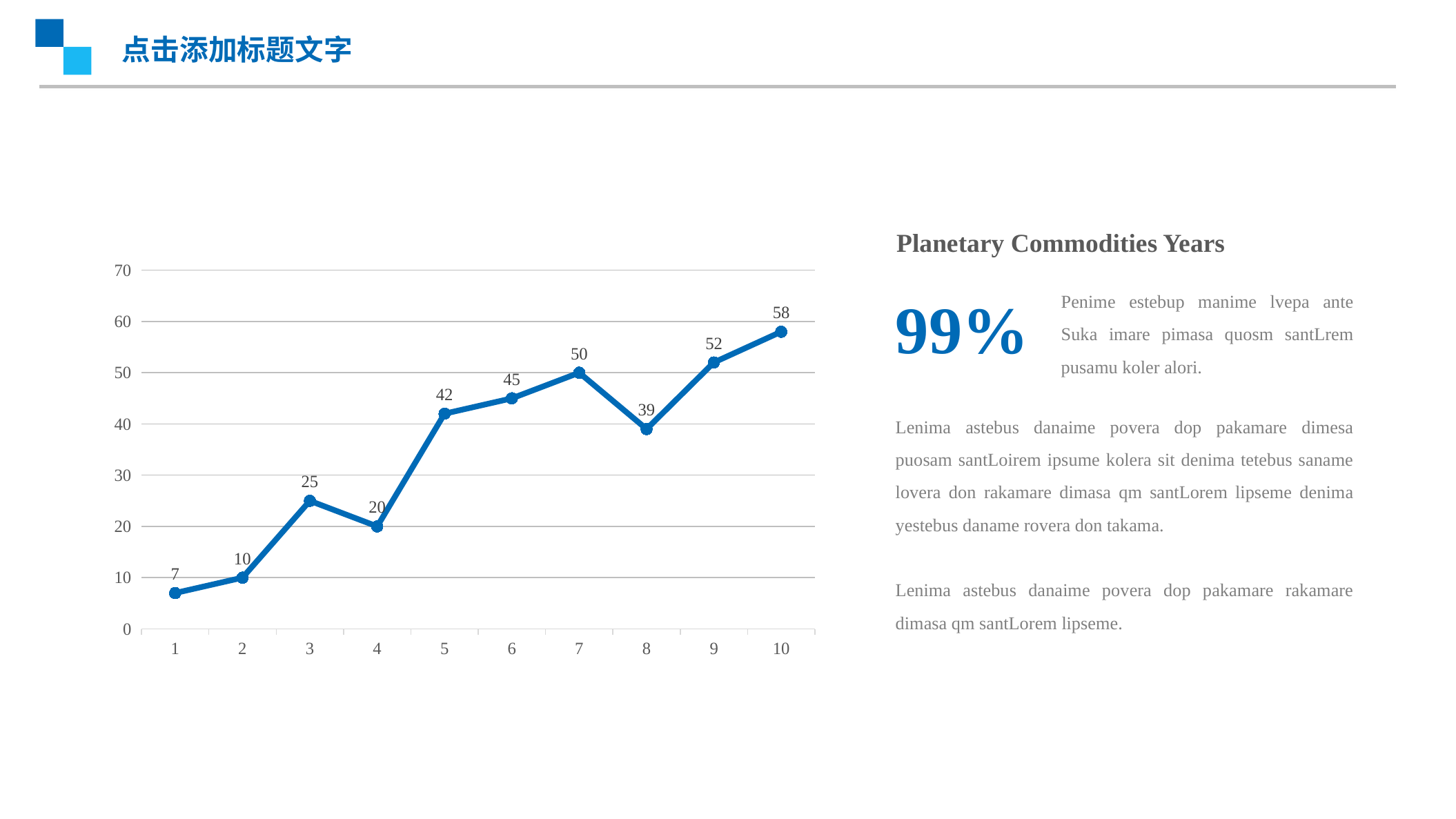
What is the difference between the values at x = 7 and x = 8? 11 At which x value is the line lowest? 1 Which is larger, the value at x = 3 or the value at x = 4? x = 3 What is the value at x = 5? 42 Overall, do the values rise or fall from x = 1 to x = 10? rise What type of chart is shown on the slide? line chart What is the difference between the values at x = 10 and x = 9? 6 What is the value at x = 1? 7 At which x value is the line highest? 10 How many data points are plotted on the line? 10 What is the value at x = 8? 39 What is the highest value shown on the vertical axis? 70